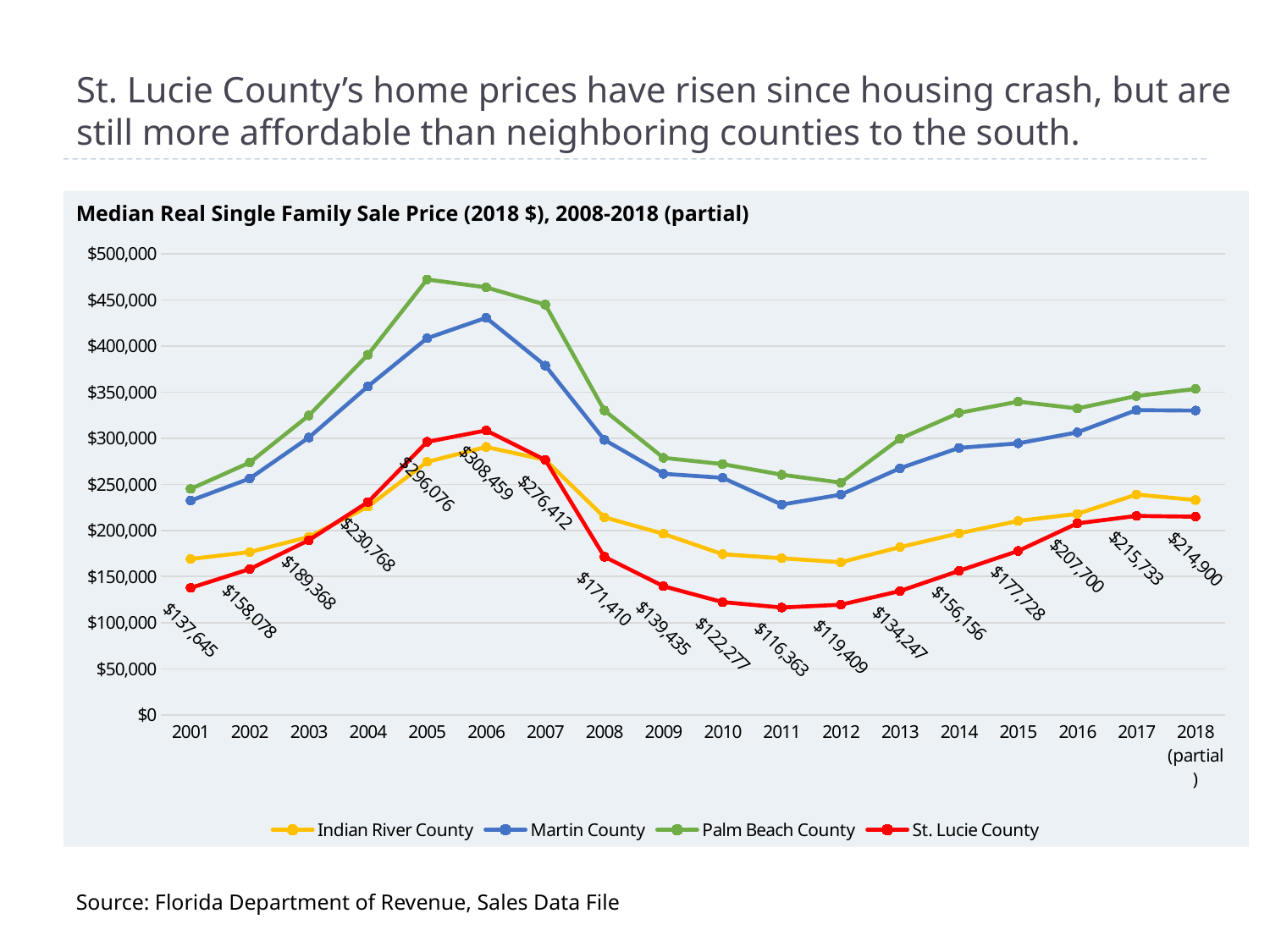
Is the value for Palm Beach County in 2005 greater or less than $450,000? greater What is the median real single family sale price for St. Lucie County in 2018 (partial)? $214,900 Is the value for Martin County in 2011 greater or less than $250,000? less How many series does the legend list? 4 Which is larger for St. Lucie County: the 2017 value or the 2018 (partial) value? 2017 What is the median real single family sale price for St. Lucie County in 2001? $137,645 What is the difference between St. Lucie County's 2006 value and its 2011 value? $192,096 How many years are plotted along the x axis? 18 In which year does the St. Lucie County line reach its highest value? 2006 What kind of chart is shown on the slide? Line chart Does the St. Lucie County line rise or fall from 2011 to 2017? Rise In which year does the St. Lucie County line reach its lowest value? 2011